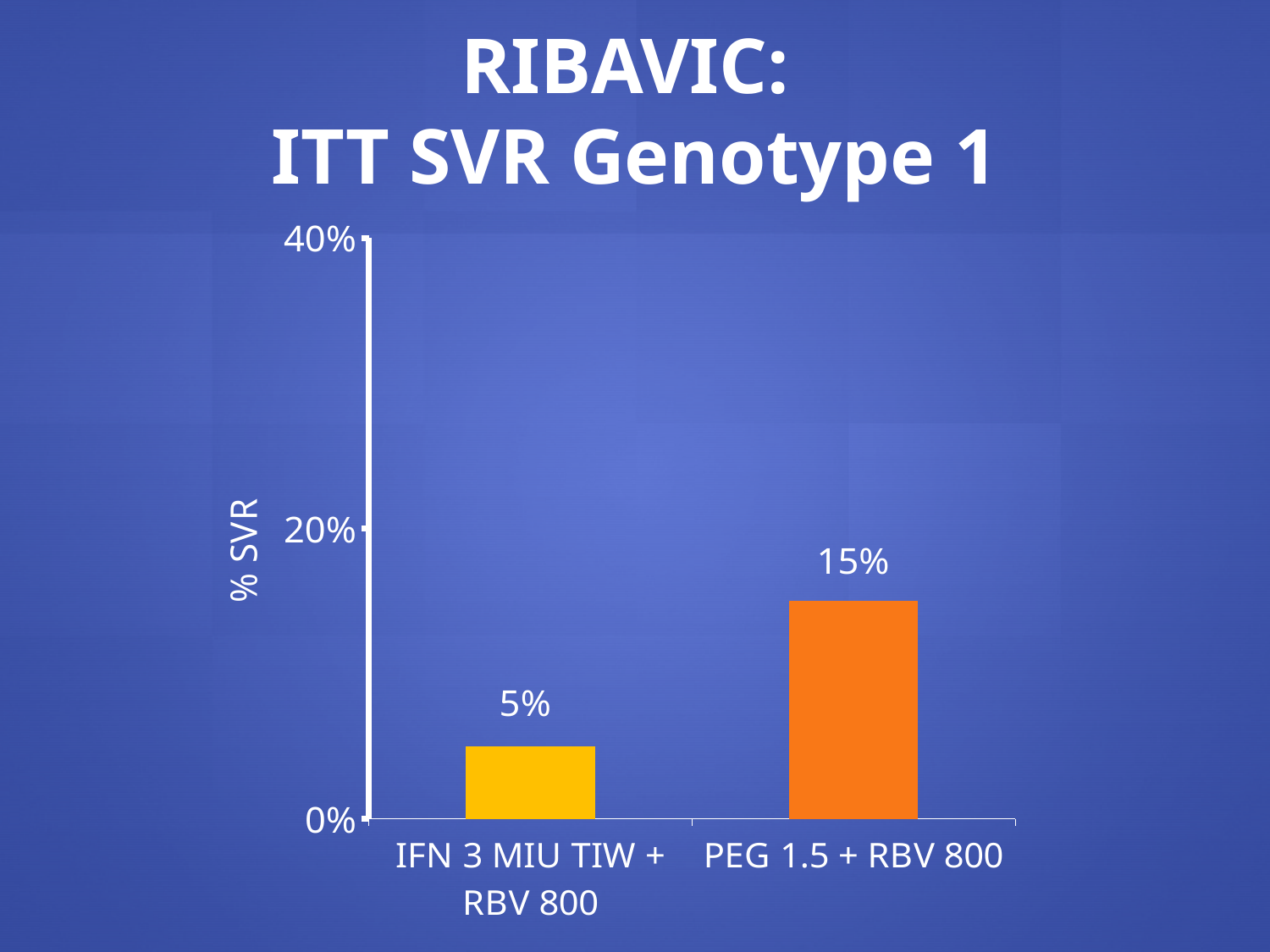
What is the difference in SVR between PEG 1.5 + RBV 800 and IFN 3 MIU TIW + RBV 800? 10% What kind of chart is shown on the slide? bar chart What is the maximum value shown on the y axis? 40% How many treatment arms are shown in the chart? 2 Which is larger, the SVR for IFN 3 MIU TIW + RBV 800 or for PEG 1.5 + RBV 800? PEG 1.5 + RBV 800 What is the SVR value for PEG 1.5 + RBV 800? 15% Which treatment arm has the highest SVR? PEG 1.5 + RBV 800 What is the SVR value for IFN 3 MIU TIW + RBV 800? 5% Which treatment arm has the lowest SVR? IFN 3 MIU TIW + RBV 800 What is the label on the y axis? % SVR Is the SVR value for PEG 1.5 + RBV 800 greater or less than 20%? less What is the title of the chart? RIBAVIC: ITT SVR Genotype 1